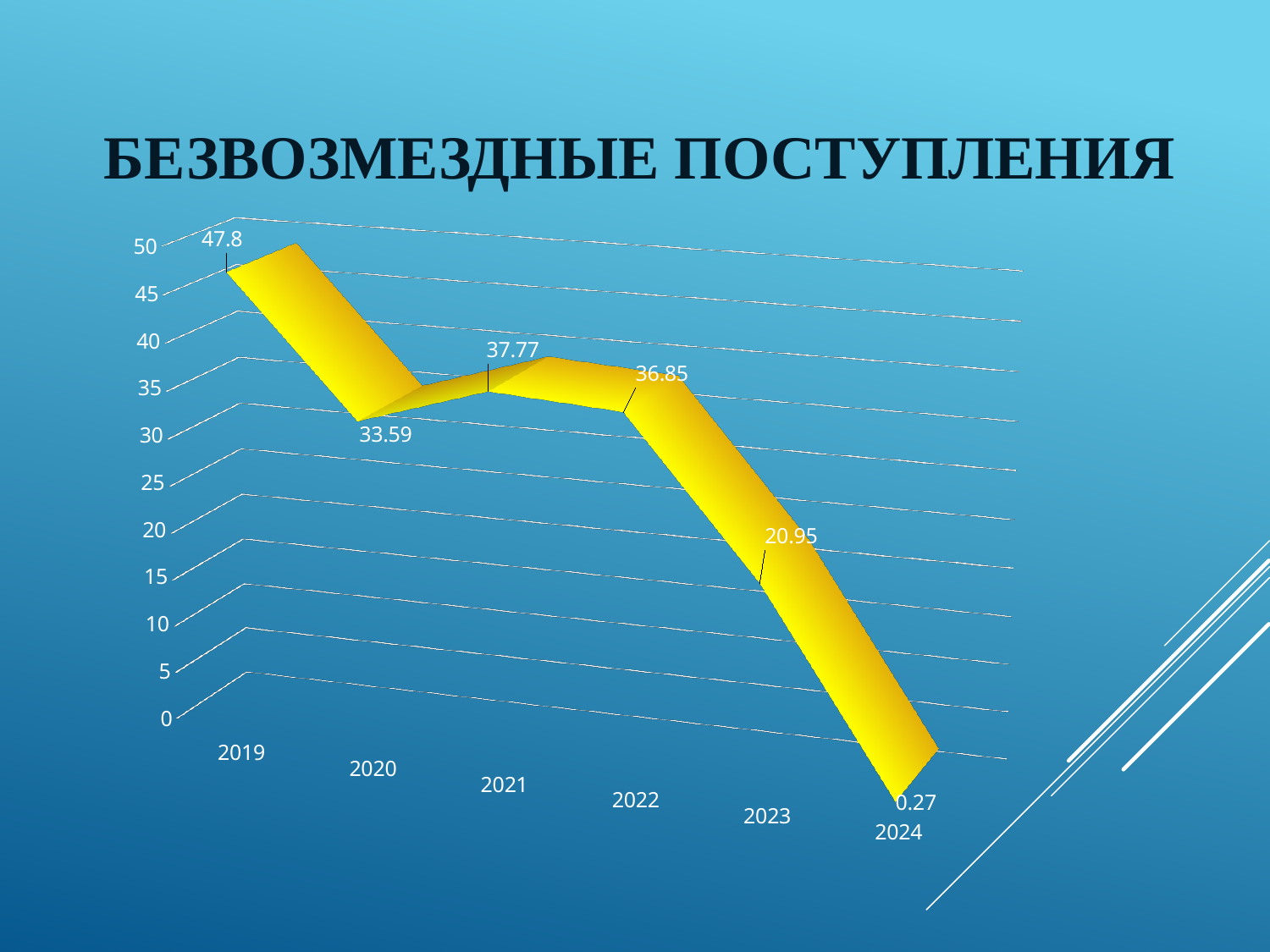
What kind of chart is shown on the slide? line chart What is the value for 2019? 47.8 What is the difference between the values for 2021 and 2022? 0.92 What is the difference between the values for 2019 and 2020? 14.21 What is the value for 2024? 0.27 Which year has the highest value? 2019 What is the title of the chart? БЕЗВОЗМЕЗДНЫЕ ПОСТУПЛЕНИЯ Is the value for 2023 greater or less than 25? less What is the value for 2023? 20.95 Which is larger, the value for 2021 or the value for 2020? 2021 Which year has the lowest value? 2024 How many years are shown on the x axis? 6